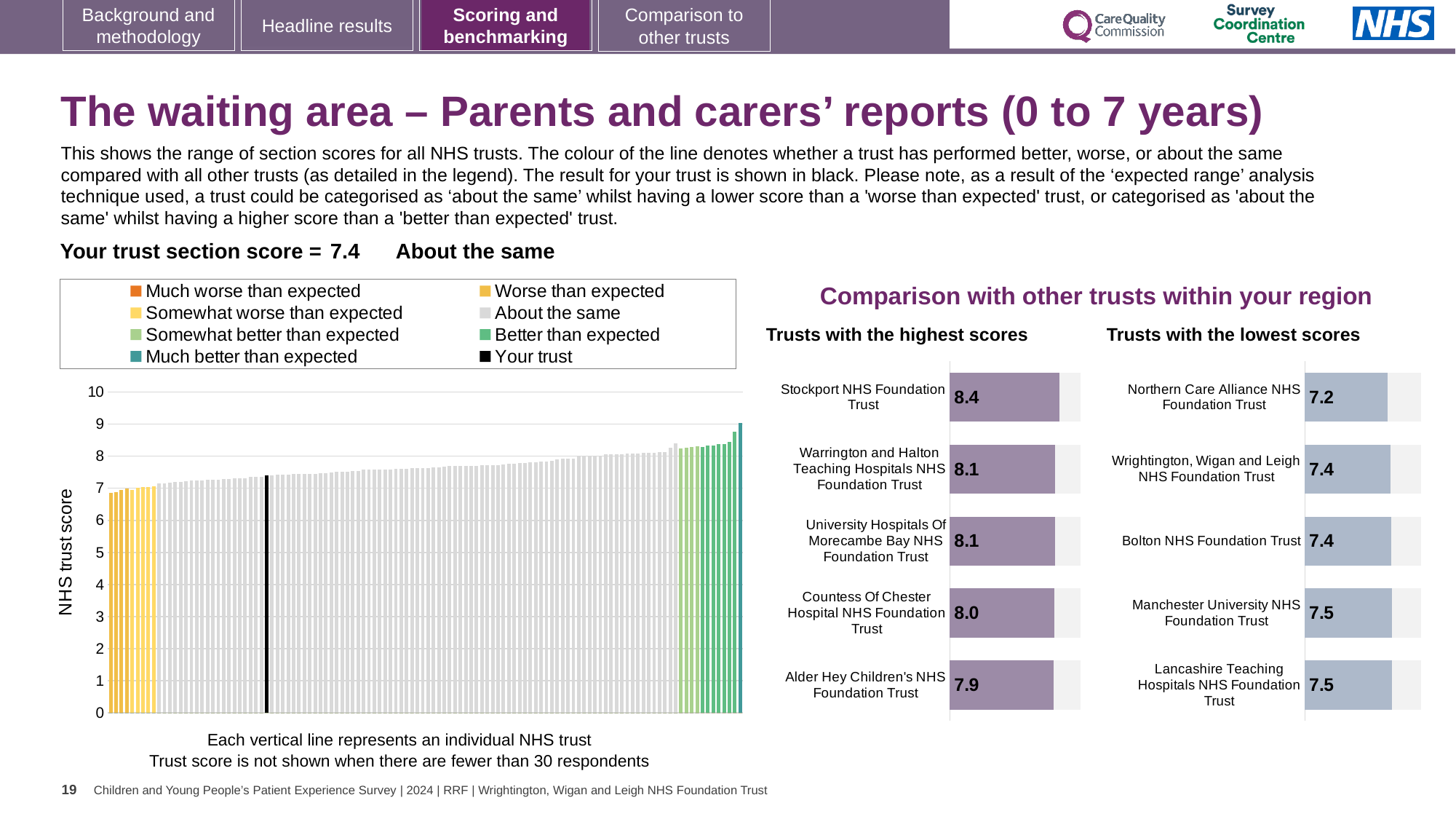
How many entries does the legend above the 'NHS trust score' chart list? 8 In the 'Trusts with the highest scores' chart, which has the larger score: Countess Of Chester Hospital NHS Foundation Trust or Alder Hey Children's NHS Foundation Trust? Countess Of Chester Hospital NHS Foundation Trust What kind of chart is the 'NHS trust score' chart on the left of the slide? bar chart In the 'NHS trust score' chart on the left, do the values rise or fall from left to right? rise In the 'Trusts with the lowest scores' chart, which trust has the lowest score? Northern Care Alliance NHS Foundation Trust In the 'Trusts with the highest scores' chart, what is the score for Stockport NHS Foundation Trust? 8.4 In the 'Trusts with the highest scores' chart, what is the difference between the scores of Stockport NHS Foundation Trust and Alder Hey Children's NHS Foundation Trust? 0.5 In the 'Trusts with the highest scores' chart, what is the score for Alder Hey Children's NHS Foundation Trust? 7.9 In the 'Trusts with the highest scores' chart, which trust has the highest score? Stockport NHS Foundation Trust In the 'Trusts with the lowest scores' chart, what is the score for Northern Care Alliance NHS Foundation Trust? 7.2 In the 'Trusts with the lowest scores' chart, how many trusts are shown? 5 In the 'Trusts with the lowest scores' chart, what is the score for Bolton NHS Foundation Trust? 7.4